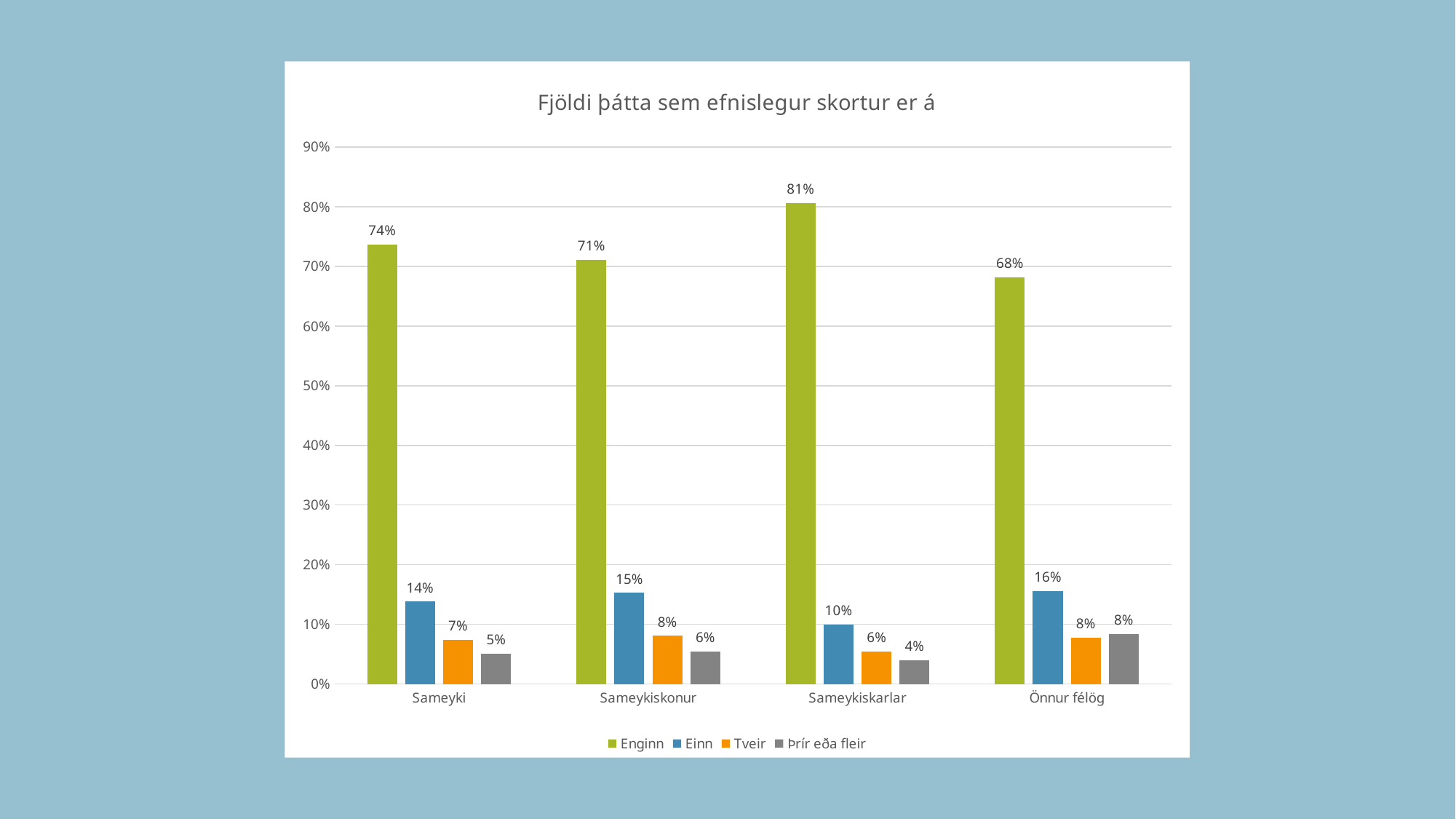
Which category has the lowest value for Einn? Sameykiskarlar Which category has the highest value for Enginn? Sameykiskarlar How many categories are shown on the x axis? 4 What is the difference between the Enginn values for Sameykiskarlar and Önnur félög? 13% Is the value for Enginn in the Sameyki category greater or less than 70%? greater Which is larger: the Einn value for Sameykiskonur or the Einn value for Sameyki? Sameykiskonur What is the value for Enginn in the Sameykiskarlar category? 81% What is the value for Einn in the Önnur félög category? 16% How many series does the legend list? 4 What is the value for Þrír eða fleir in the Sameykiskonur category? 6% What is the value for Tveir in the Sameyki category? 7% What kind of chart is shown on the slide? Bar chart